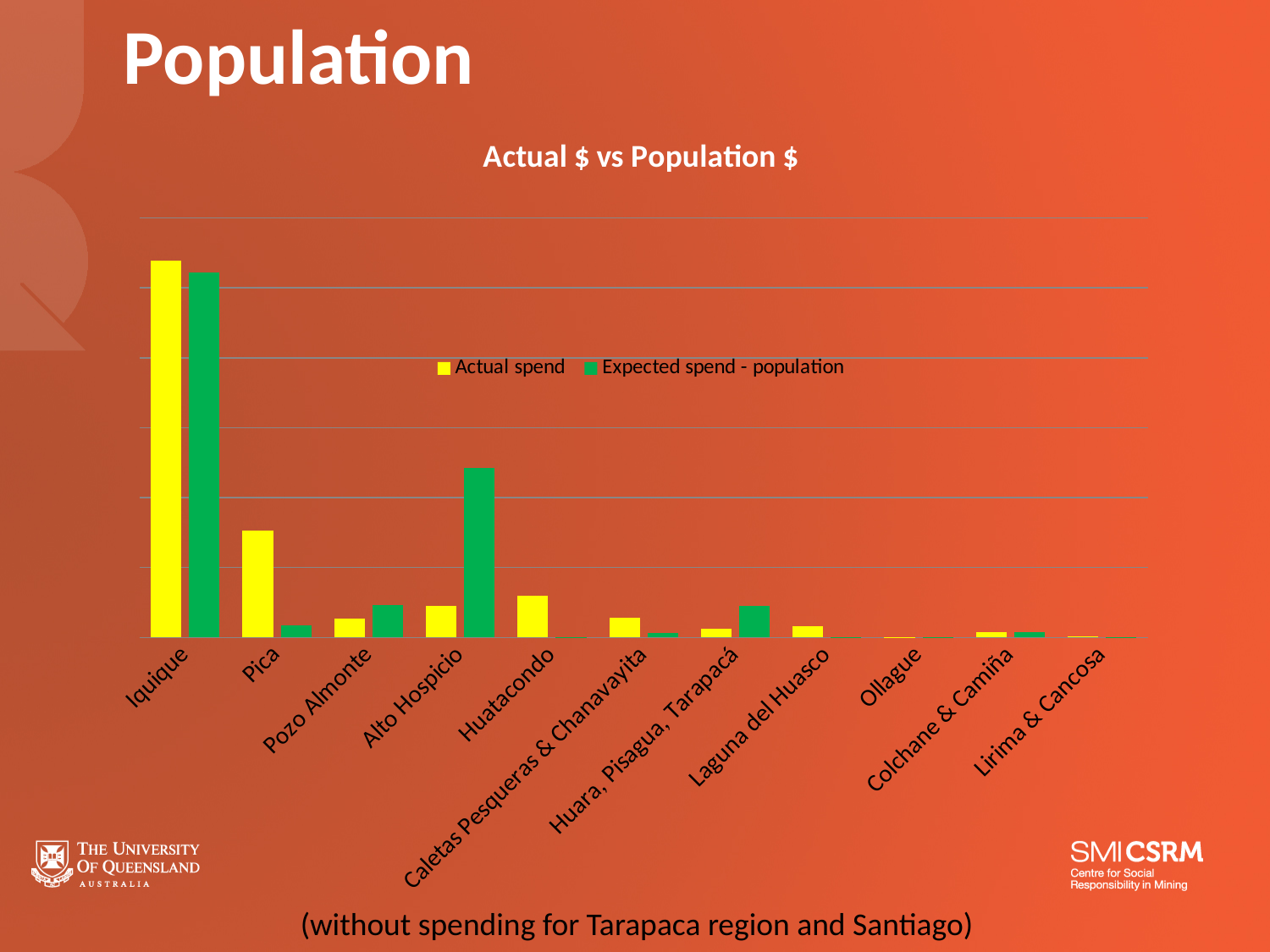
What is the title of the chart? Actual $ vs Population $ For Alto Hospicio, which is larger: Actual spend or Expected spend - population? Expected spend - population For Pica, which is larger: Actual spend or Expected spend - population? Actual spend Which category has the highest Expected spend - population? Iquique Which colour represents Actual spend in the chart? Yellow Which category has the larger Actual spend: Pica or Pozo Almonte? Pica Which category has the highest Actual spend? Iquique How many series does the chart's legend list? 2 What kind of chart is shown on the slide? Bar chart How many categories are shown along the x axis of the chart? 11